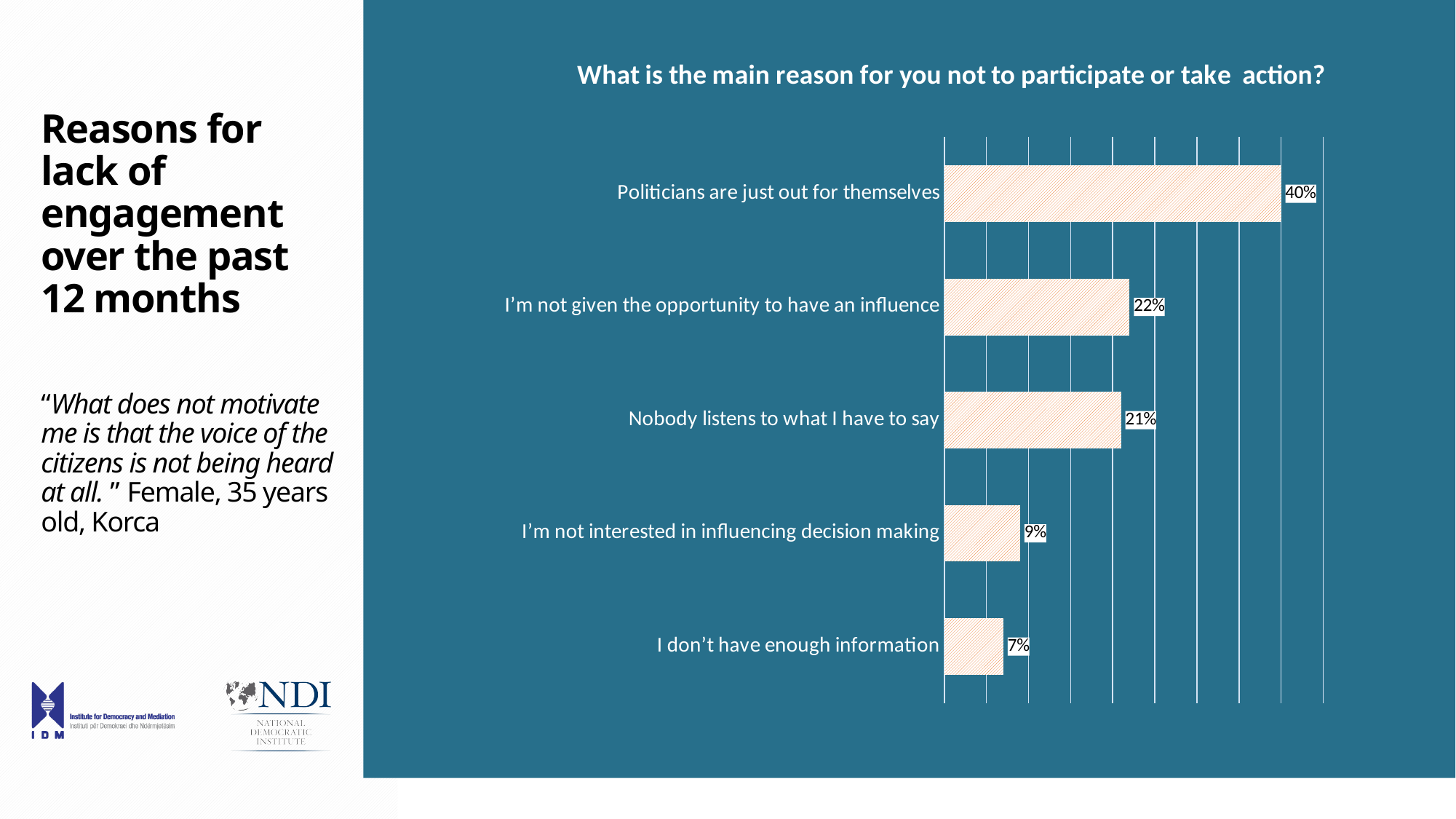
What is the title of the chart? What is the main reason for you not to participate or take action? How many reasons are shown in the chart? 5 Which is larger: "Nobody listens to what I have to say" or "I'm not interested in influencing decision making"? Nobody listens to what I have to say Which reason has the highest value? Politicians are just out for themselves What is the value for "Nobody listens to what I have to say"? 21% What percentage of respondents said "Politicians are just out for themselves"? 40% What kind of chart is shown on the slide? Bar chart What is the value for "I don't have enough information"? 7% What is the difference between "I'm not interested in influencing decision making" and "I don't have enough information"? 2% What is the value for "I'm not given the opportunity to have an influence"? 22% What is the difference between "Politicians are just out for themselves" and "I'm not given the opportunity to have an influence"? 18% Which reason has the lowest value? I don't have enough information